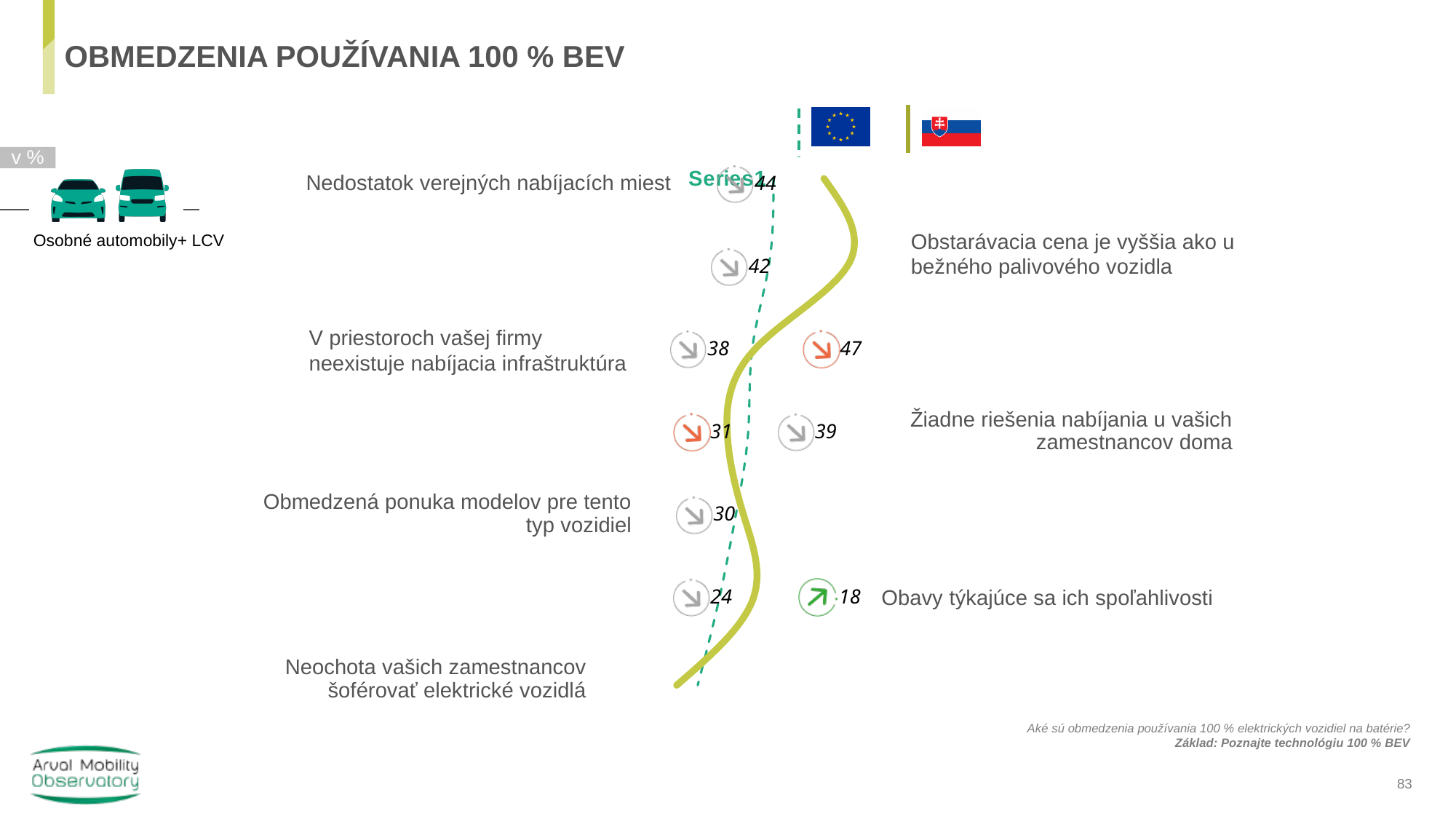
Which two values are printed in the row for "Žiadne riešenia nabíjania u vašich zamestnancov doma"? 31 and 39 What value is printed in the row for "Obstarávacia cena je vyššia ako u bežného palivového vozidla"? 42 What value is printed next to the marker for "Nedostatok verejných nabíjacích miest"? 44 Which two values are printed in the row for "Obavy týkajúce sa ich spoľahlivosti"? 24 and 18 What value is printed for "Obmedzená ponuka modelov pre tento typ vozidiel"? 30 What legend entry text is visible on the chart? Series1 What is the lowest value printed on the chart? 18 What is the difference between the two values printed in the row for "V priestoroch vašej firmy neexistuje nabíjacia infraštruktúra" (47 and 38)? 9 Which is larger: the value for "Nedostatok verejných nabíjacích miest" or the value for "Obstarávacia cena je vyššia ako u bežného palivového vozidla"? Nedostatok verejných nabíjacích miest What is the highest value printed on the chart? 47 Which two values are printed in the row for "V priestoroch vašej firmy neexistuje nabíjacia infraštruktúra"? 38 and 47 What kind of chart is shown on the slide? Line chart